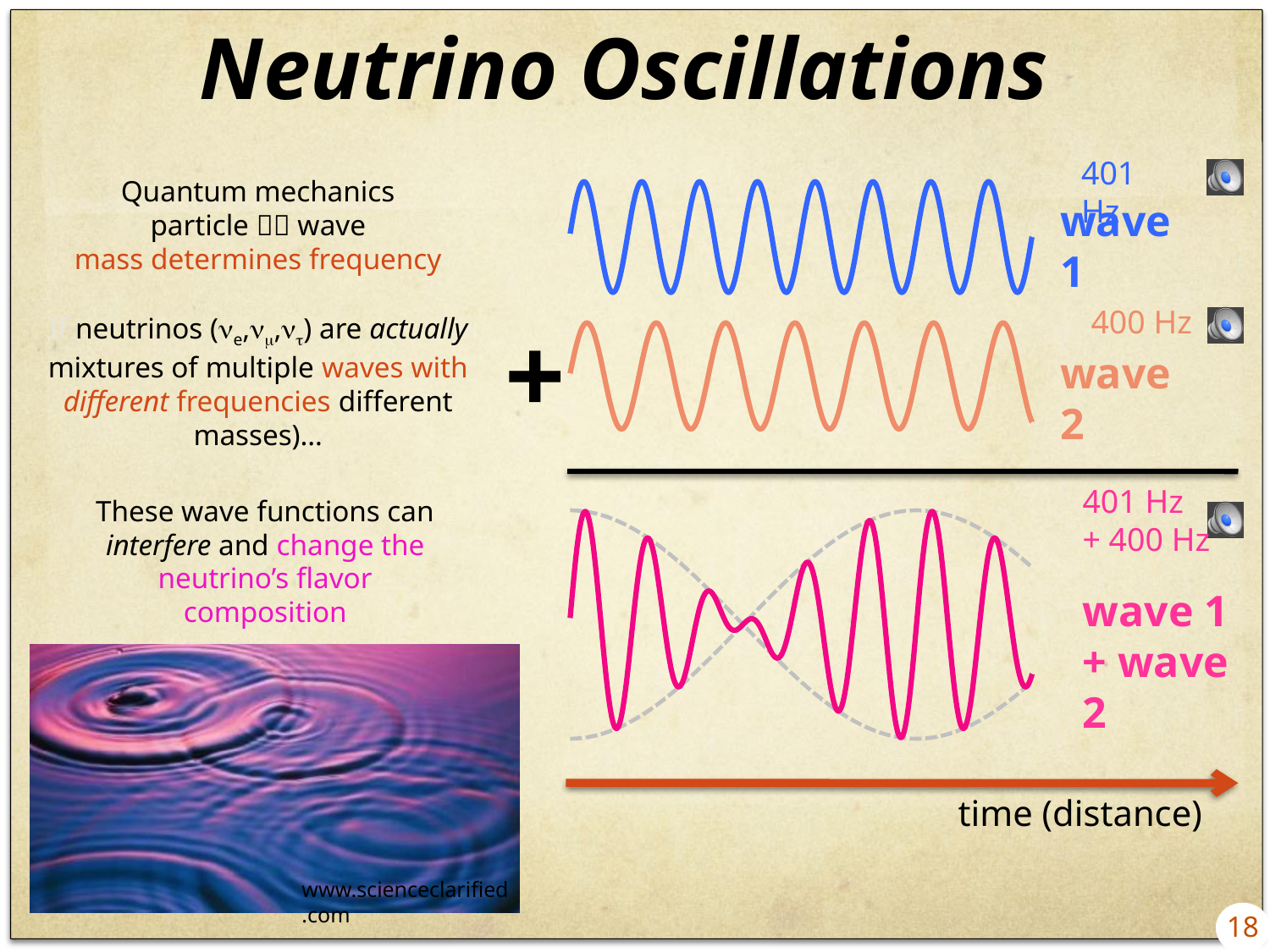
What frequency is labeled for wave 1? 401 Hz What colour is the wave 1 plot? blue What is the label on the horizontal axis arrow below the bottom wave plot? time (distance) How many separate wave plots are shown on the right side of the slide? 3 Which has the higher labeled frequency, wave 1 or wave 2? wave 1 What is the label of the bottom wave plot? wave 1 + wave 2 What frequencies are labeled for the bottom combined wave plot? 401 Hz + 400 Hz What is the difference between the labeled frequencies of wave 1 and wave 2? 1 Hz What kind of plot is used to show the waves? line chart What frequency is labeled for wave 2? 400 Hz